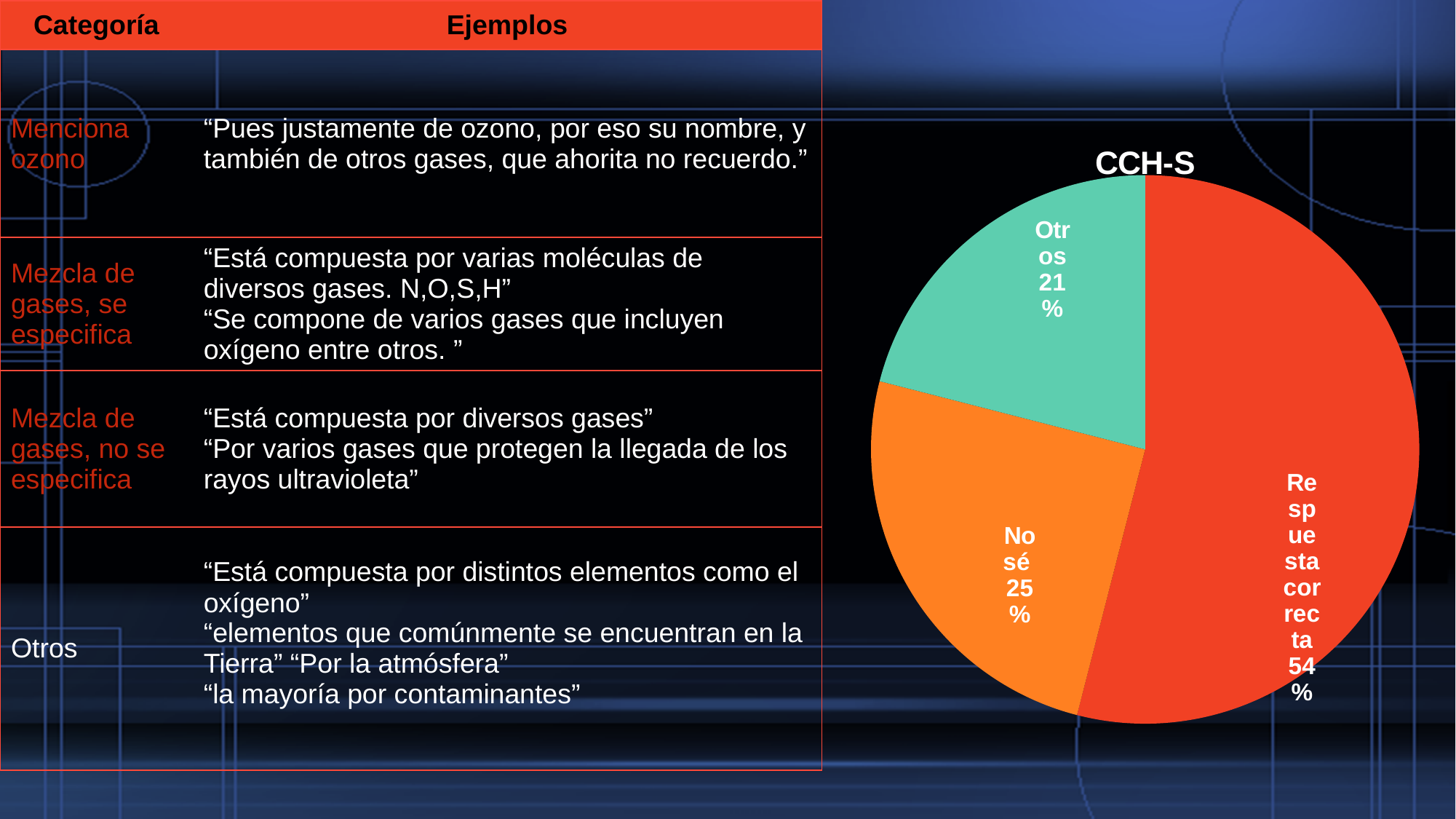
What colour is the "Respuesta correcta" slice of the pie chart? red What percentage of the pie chart is labelled "Otros"? 21% How many slices does the pie chart have? 3 What is the title of the pie chart? CCH-S What kind of chart is shown on the slide? pie chart What is the difference in percentage points between the "No sé" slice and the "Otros" slice? 4 Which slice of the pie chart is the smallest? Otros What percentage of the pie chart is labelled "No sé"? 25% What percentage of the pie chart is labelled "Respuesta correcta"? 54% What is the difference in percentage points between the "Respuesta correcta" slice and the "No sé" slice? 29 Which slice of the pie chart is the largest? Respuesta correcta Which is larger in the pie chart, "No sé" or "Otros"? No sé